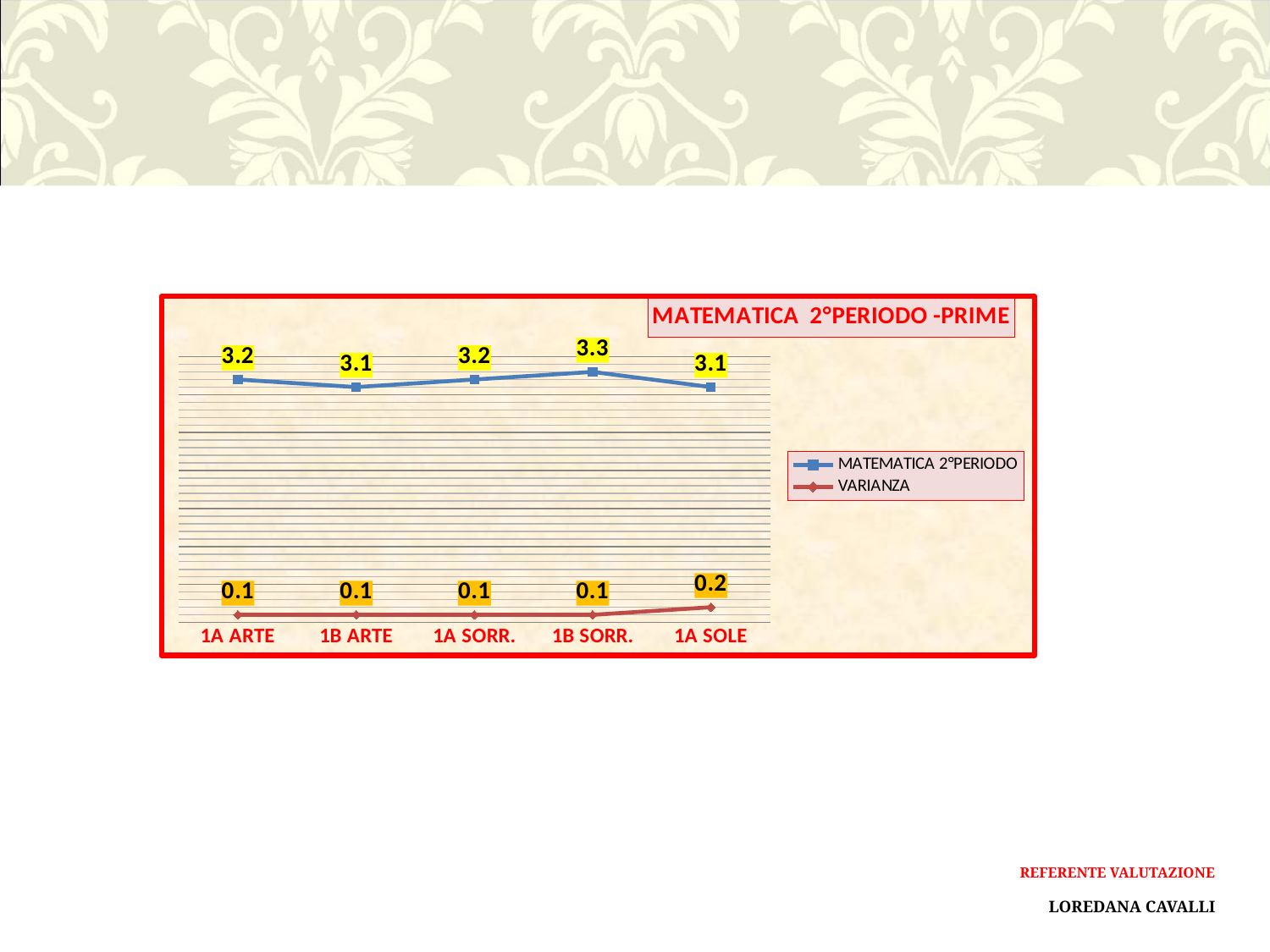
What is the title of the chart? MATEMATICA 2°PERIODO -PRIME What kind of chart is shown? line chart What is the MATEMATICA 2°PERIODO value for 1A ARTE? 3.2 What is the VARIANZA value for 1A SOLE? 0.2 How many series does the legend list? 2 Which category has the highest VARIANZA value? 1A SOLE Which series is drawn in blue? MATEMATICA 2°PERIODO What is the difference between the MATEMATICA 2°PERIODO values for 1B SORR. and 1B ARTE? 0.2 Which is larger, the MATEMATICA 2°PERIODO value for 1A SORR. or for 1A SOLE? 1A SORR. Which category has the highest MATEMATICA 2°PERIODO value? 1B SORR. What is the MATEMATICA 2°PERIODO value for 1B SORR.? 3.3 How many categories are shown on the x axis? 5